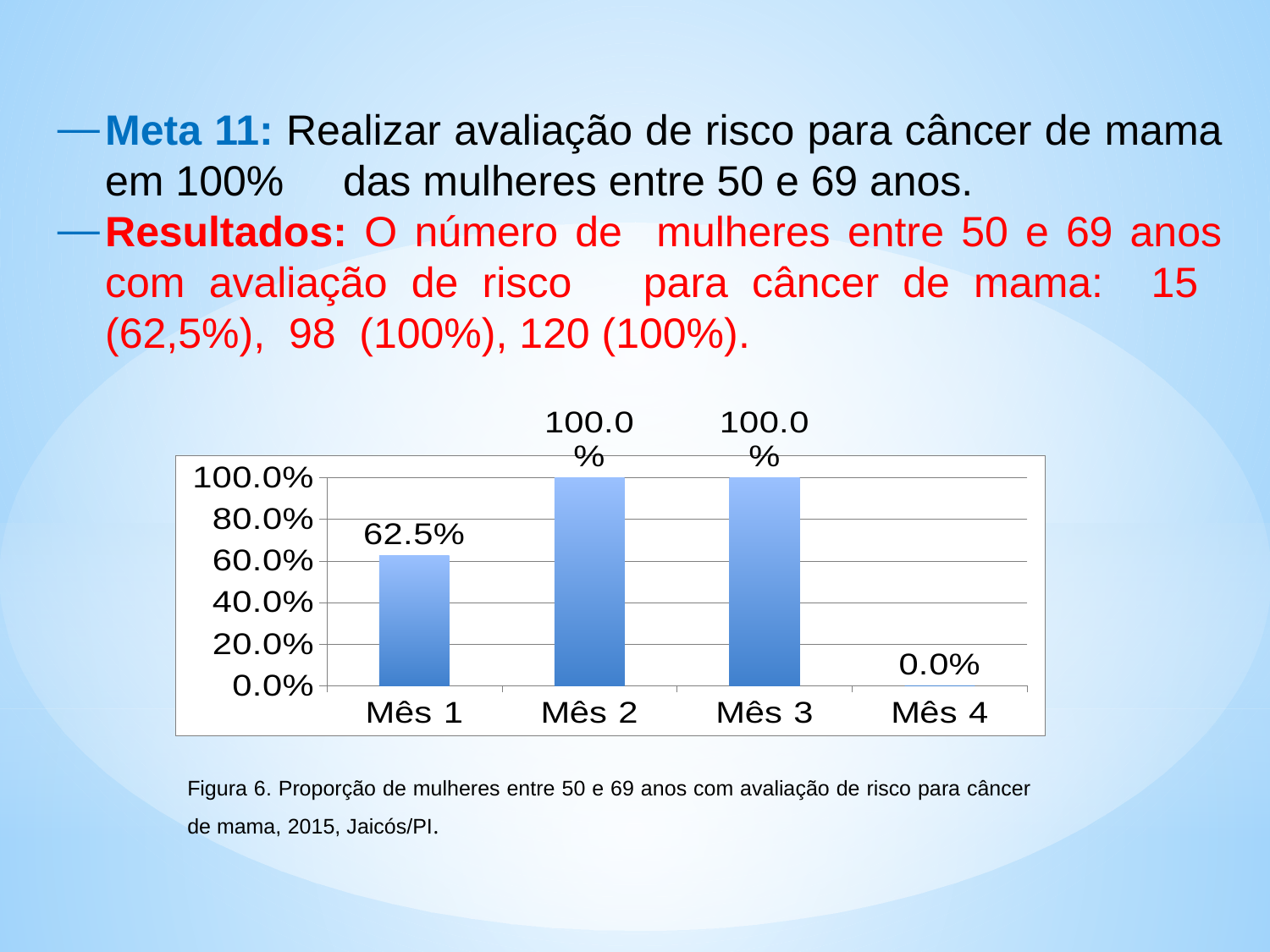
Do the values rise or fall from Mês 3 to Mês 4? fall Do Mês 2 and Mês 3 have the same value? yes Is the value for Mês 1 greater or less than 80.0%? less What is the highest tick label on the y axis? 100.0% Which category has the lowest value? Mês 4 What is the value for Mês 1? 62.5% What is the value for Mês 2? 100.0% What kind of chart is shown on the slide? bar chart What is the value for Mês 4? 0.0% What is the difference between the values for Mês 2 and Mês 1? 37.5% Which is larger, the value for Mês 1 or the value for Mês 3? Mês 3 How many categories are shown on the x axis? 4